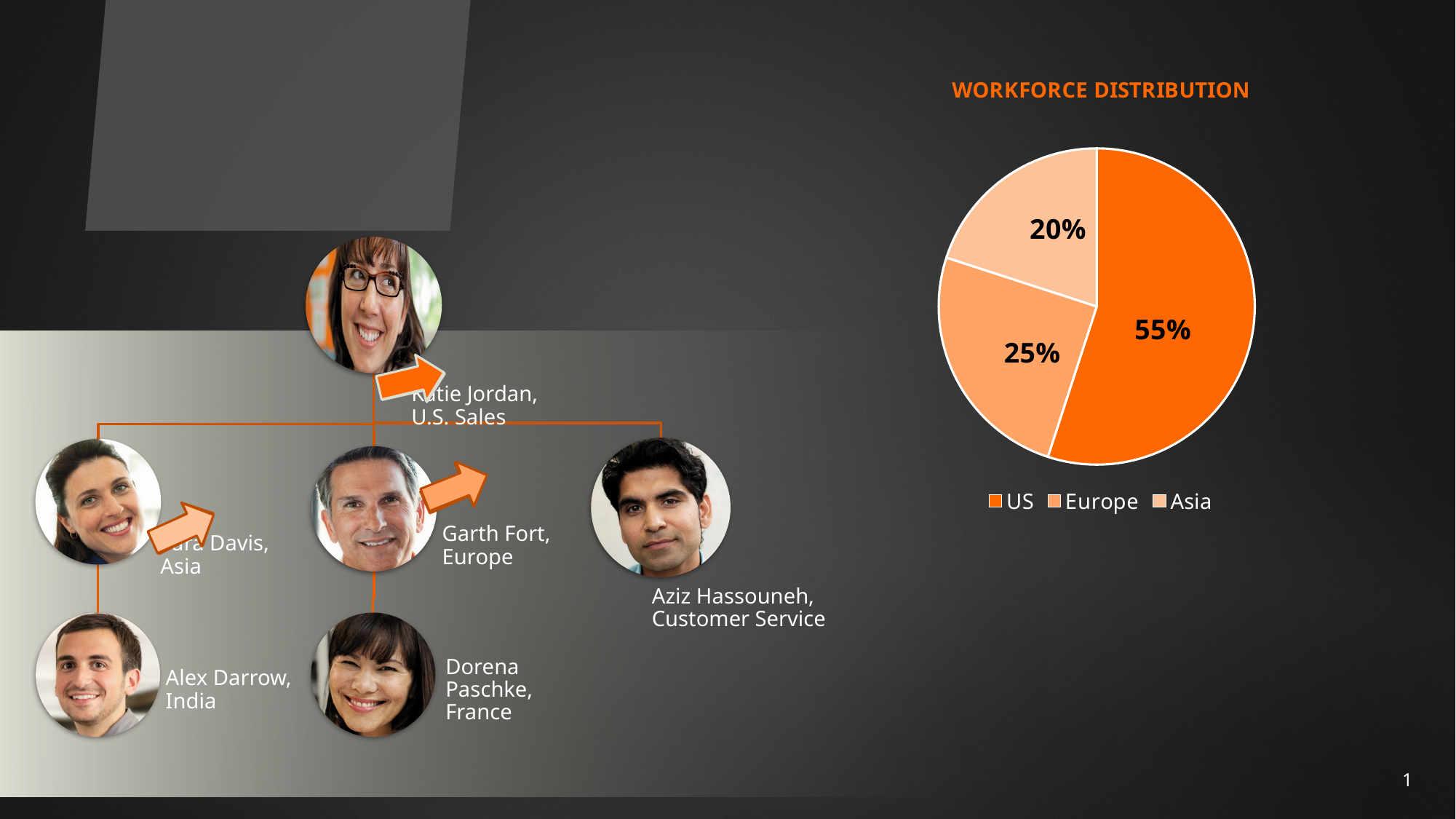
Which has a larger share of the workforce, Europe or Asia? Europe Which region has the smallest share of the workforce? Asia What kind of chart is shown on the slide? pie chart Which regions are listed in the legend of the pie chart? US, Europe, Asia What share of the workforce is in Asia? 20% How many regions are shown in the pie chart? 3 What is the title of the pie chart? WORKFORCE DISTRIBUTION What share of the workforce is in the US? 55% Which region has the largest share of the workforce? US What share of the workforce is in Europe? 25% What is the difference between the Europe share and the Asia share? 5% What is the difference between the US share and the Europe share? 30%